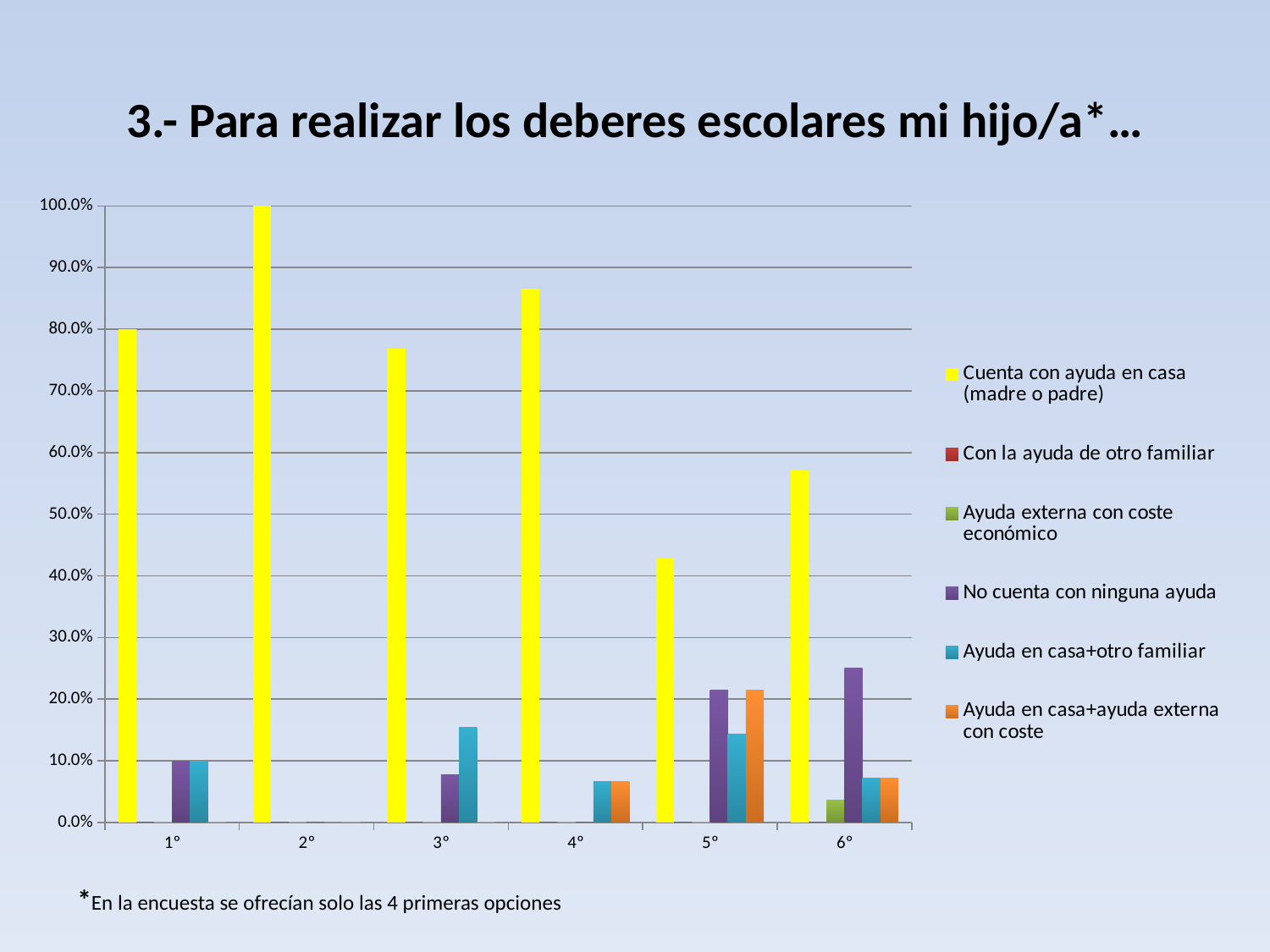
What kind of chart is shown on the slide? bar chart Which category has the highest value for 'Cuenta con ayuda en casa (madre o padre)'? 2° Is the value of 'Cuenta con ayuda en casa (madre o padre)' for 5° greater or less than 50.0%? less Is the value of 'Cuenta con ayuda en casa (madre o padre)' for 4° greater or less than 80.0%? greater What is the value of 'Cuenta con ayuda en casa (madre o padre)' for 1°? 80.0% How many series does the legend list? 6 Is the value of 'No cuenta con ninguna ayuda' for 6° greater or less than 20.0%? greater What is the value of 'Cuenta con ayuda en casa (madre o padre)' for 2°? 100.0% Which category has the lowest value for 'Cuenta con ayuda en casa (madre o padre)'? 5° How many categories are shown on the x axis? 6 Which is larger for 'Cuenta con ayuda en casa (madre o padre)': 3° or 4°? 4° What colour represents 'Cuenta con ayuda en casa (madre o padre)' in the legend? yellow